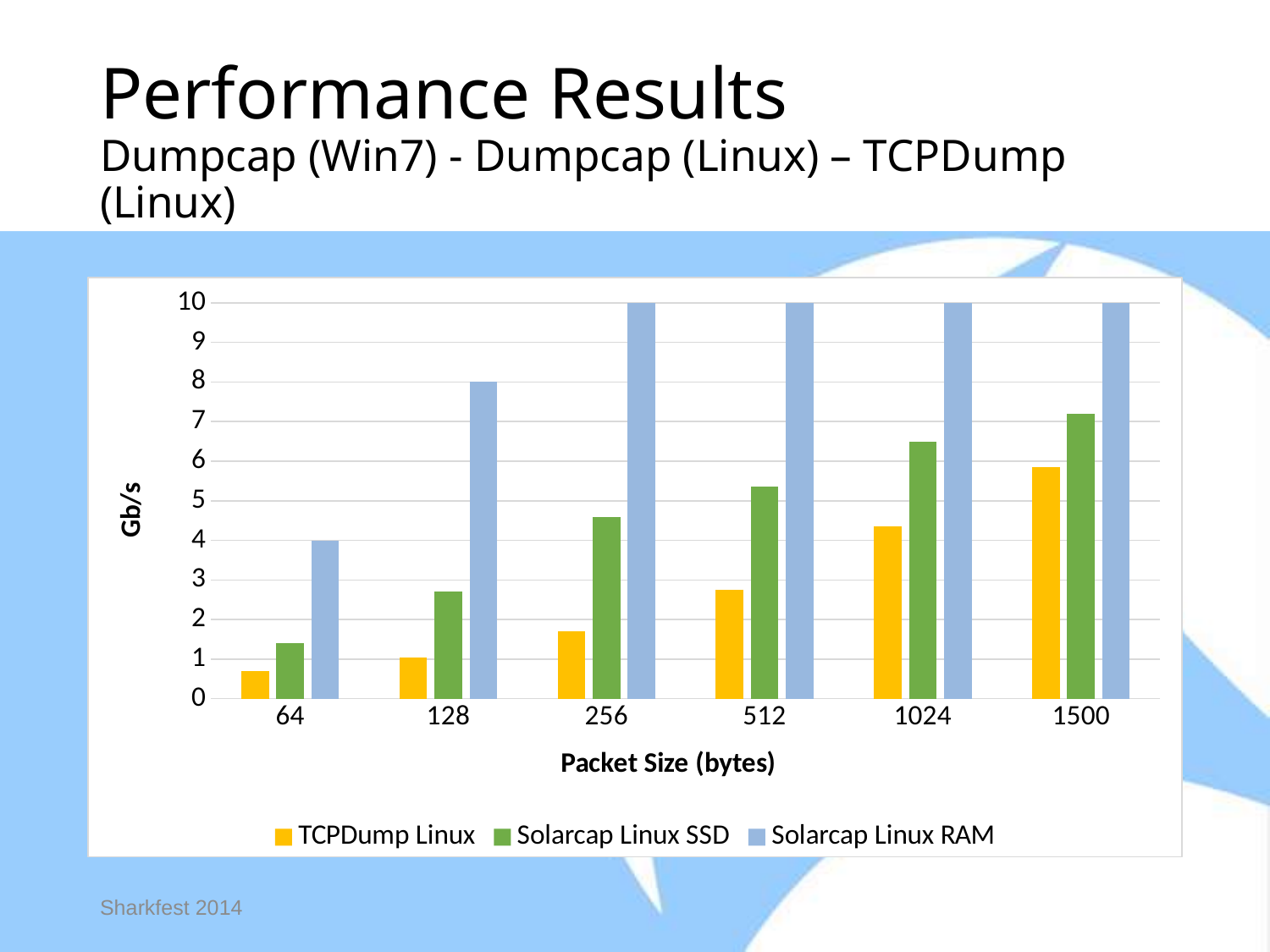
Which series has the highest value at packet size 512? Solarcap Linux RAM How many series does the legend list? 3 What kind of chart is shown on the slide? bar chart Is the value for Solarcap Linux SSD at packet size 64 greater or less than 2? less How many packet size categories are shown on the x axis? 6 What is the value for Solarcap Linux RAM at packet size 64? 4 Which series has the lowest value at packet size 1024? TCPDump Linux What is the difference between the Solarcap Linux RAM values at packet sizes 128 and 64? 4 What is the value for Solarcap Linux RAM at packet size 1500? 10 Is the value for TCPDump Linux at packet size 1500 greater or less than 5? greater What is the value for Solarcap Linux RAM at packet size 128? 8 Do the TCPDump Linux values rise or fall as packet size increases along the x axis? rise